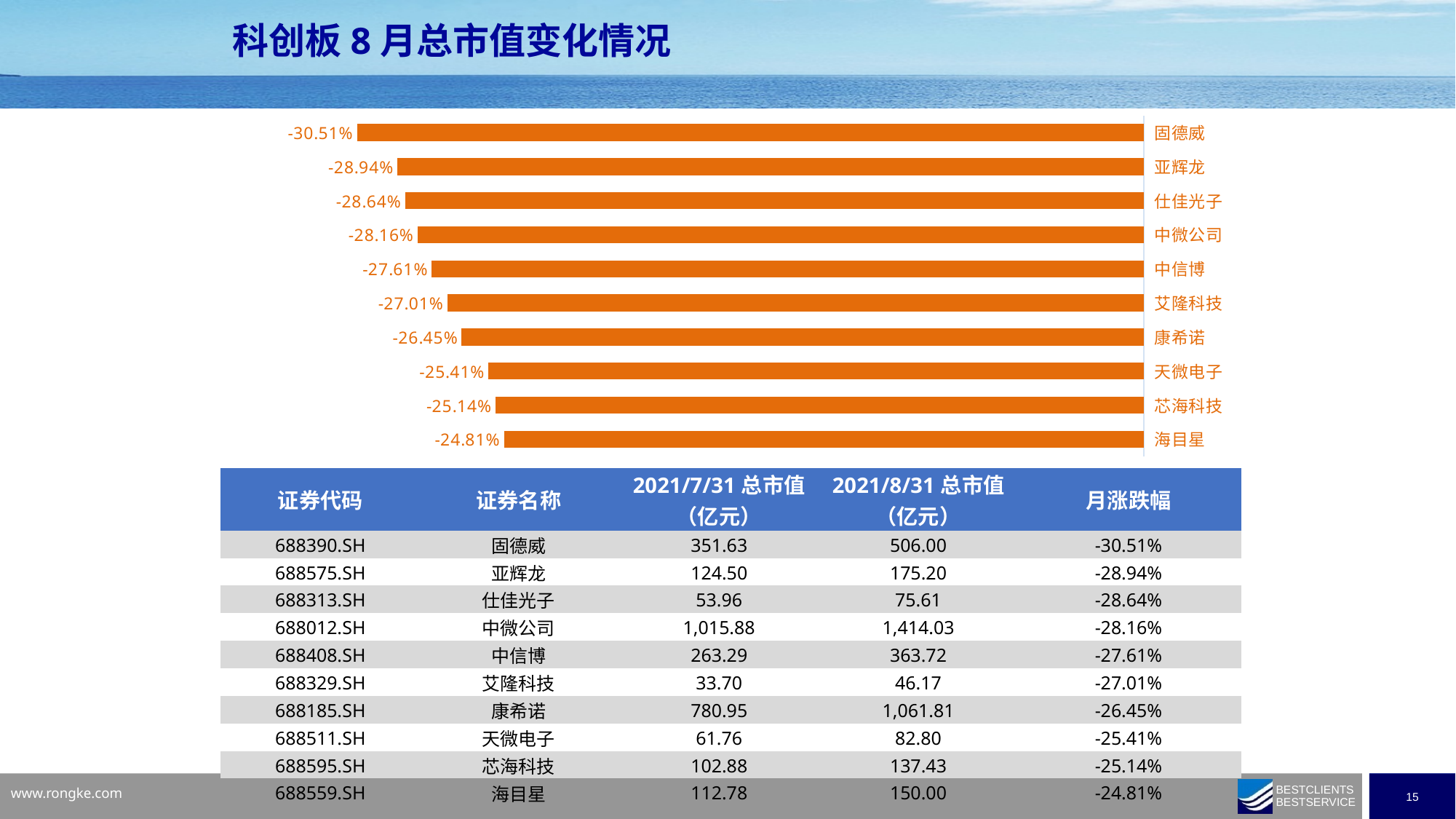
What is the value shown for 中微公司 in the bar chart? -28.16% What kind of chart is shown on the slide? Bar chart Which has the larger (less negative) value, 中信博 or 天微电子? 天微电子 What is the difference in percentage points between the values for 亚辉龙 and 仕佳光子? 0.30 percentage points What colour are the bars in the chart? Orange What is the difference in percentage points between the values for 固德威 and 海目星? 5.70 percentage points What is the value shown for 固德威 in the bar chart? -30.51% What is the value shown for 康希诺 in the bar chart? -26.45% How many companies are shown in the bar chart? 10 Which company has the lowest (most negative) value in the bar chart? 固德威 Which company has the highest (least negative) value in the bar chart? 海目星 What is the value shown for 海目星 in the bar chart? -24.81%